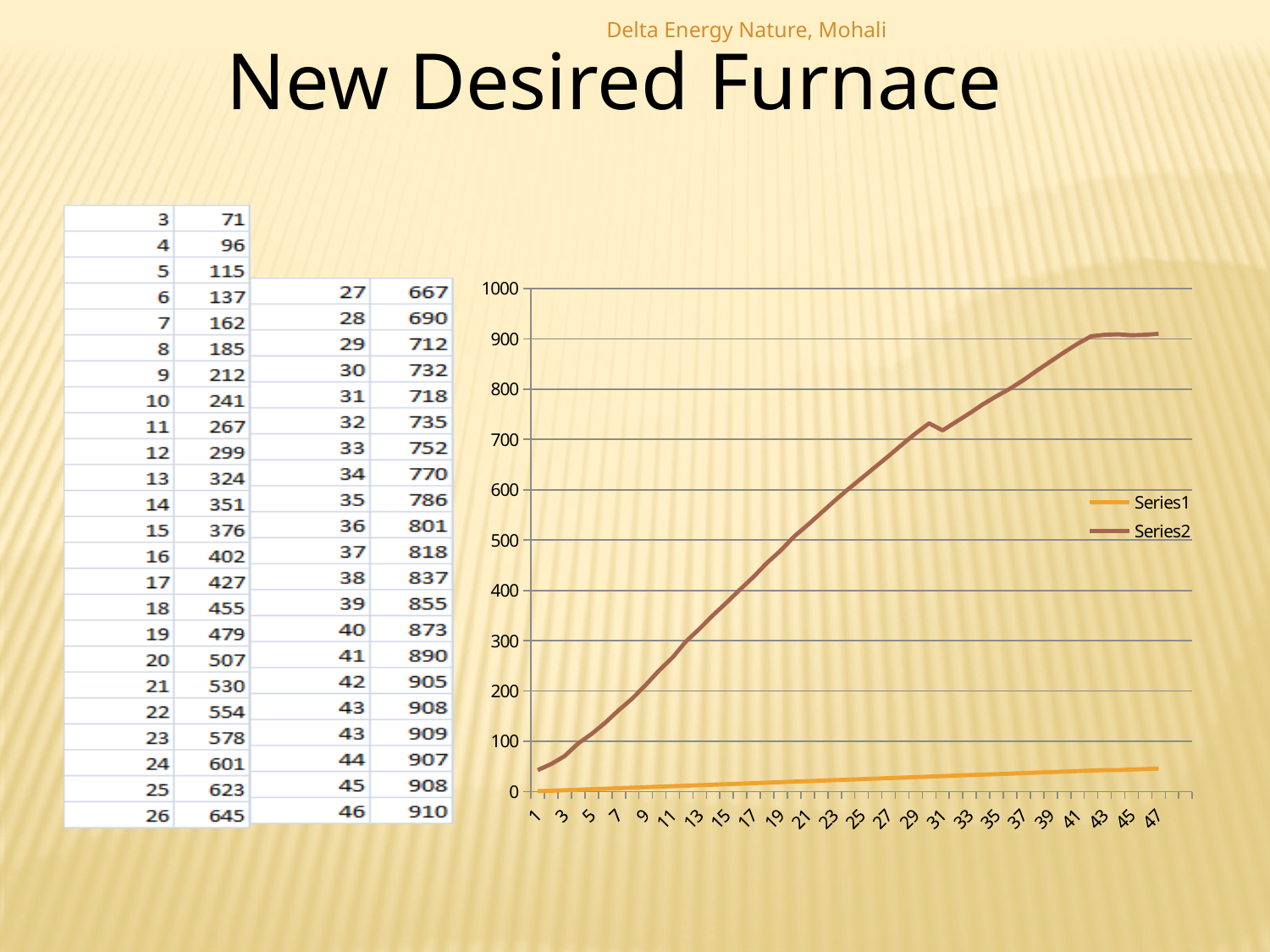
Is the value of Series2 at x = 21 greater or less than 500? greater Is the value of Series2 at x = 1 greater or less than 100? less What kind of chart is shown on the slide? line chart Is the value of Series2 at x = 41 greater or less than 800? greater At x = 25, which series has the larger value, Series1 or Series2? Series2 Which series is plotted in brown? Series2 Which series has the higher value at x = 47? Series2 What is the highest value shown on the chart's vertical axis? 1000 How many series does the chart legend list? 2 Does Series2 generally rise or fall as the x axis goes from 1 to 47? rise